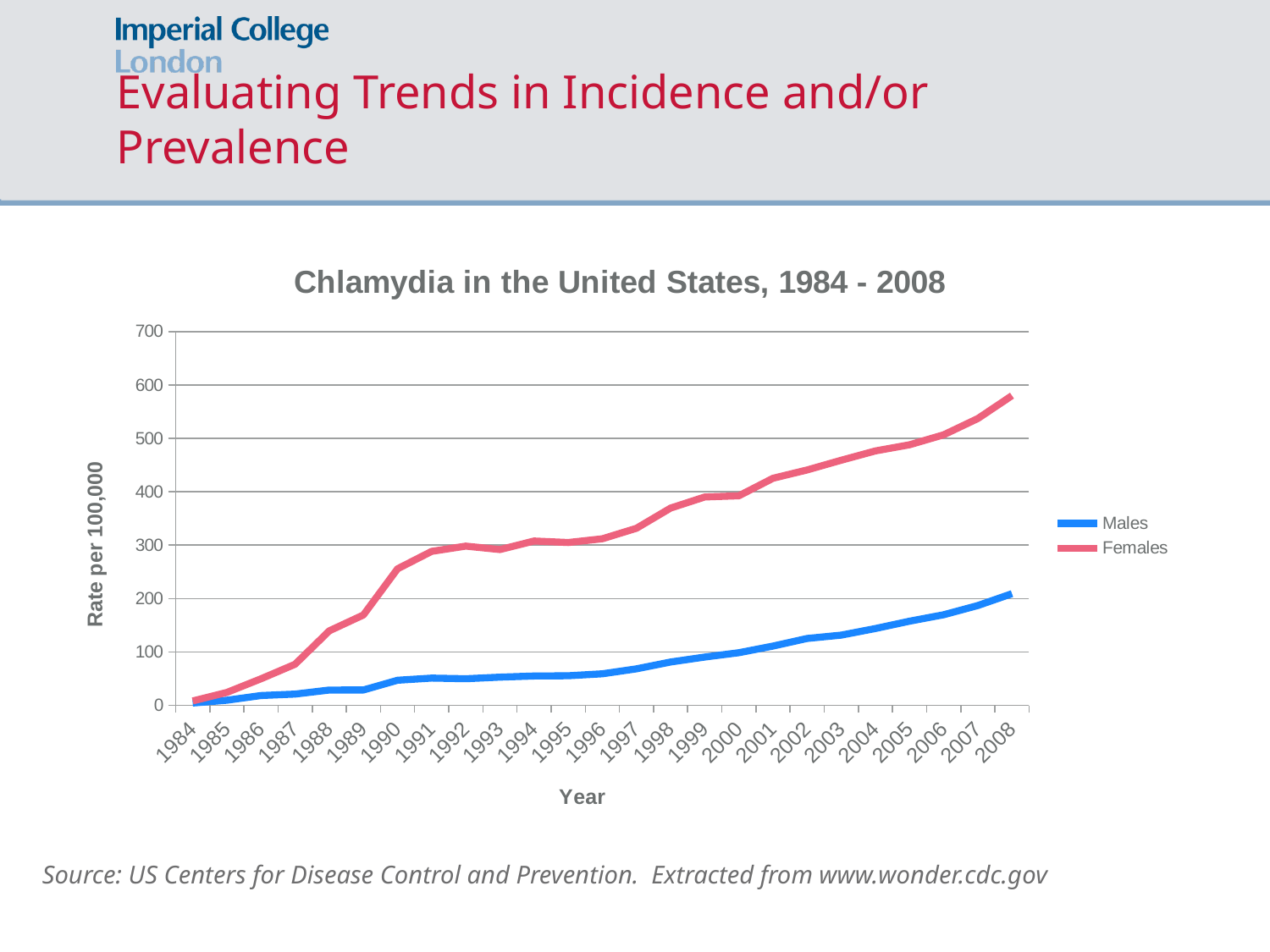
In which year is the Males rate lowest? 1984 Is the value for Females in 2008 greater or less than 500? greater What is the title of the chart? Chlamydia in the United States, 1984 - 2008 In which year is the Females rate highest? 2008 Do the values for Females rise or fall from 1984 to 2008? rise What kind of chart is shown on the slide? line chart How many series does the legend list? 2 Is the value for Females in 1990 greater or less than 200? greater Which series is higher in 2008, Males or Females? Females Is the value for Males in 2008 greater or less than 300? less How many years are plotted along the x axis? 25 What is the label of the y axis? Rate per 100,000